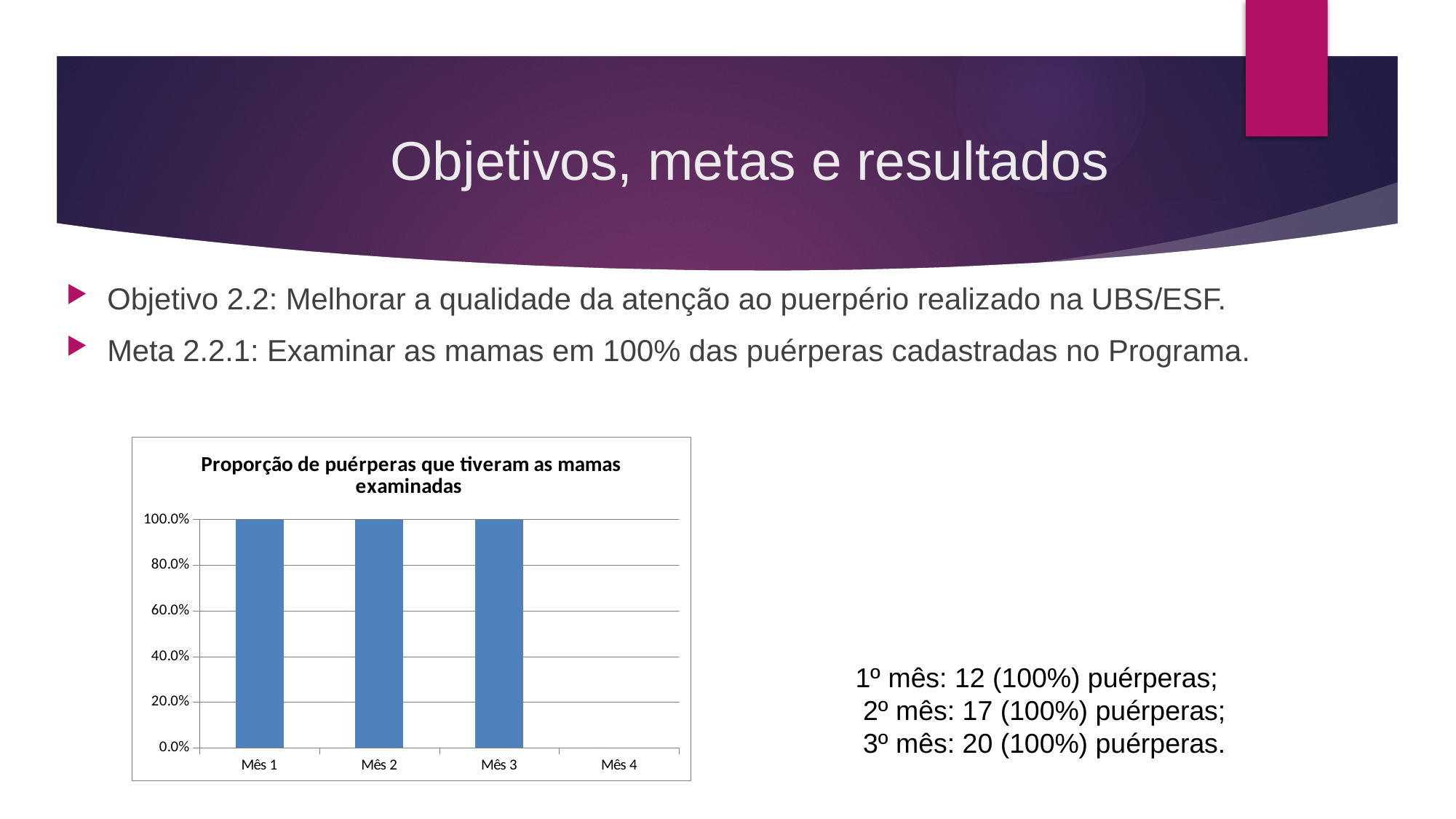
How many categories are shown on the x axis of the chart? 4 What is the highest value shown on the y axis of the chart? 100.0% Is the value for Mês 3 greater or less than 60.0%? greater What kind of chart is shown on the slide? bar chart What is the title of the chart? Proporção de puérperas que tiveram as mamas examinadas What is the value for Mês 1 in the chart? 100.0% Is the value for Mês 2 greater or less than 80.0%? greater Do the values rise, fall or stay the same from Mês 1 to Mês 3? stay the same Which category in the chart has no bar plotted? Mês 4 What is the value for Mês 3 in the chart? 100.0% What is the value for Mês 2 in the chart? 100.0% What is the difference between the values for Mês 1 and Mês 3? 0.0%